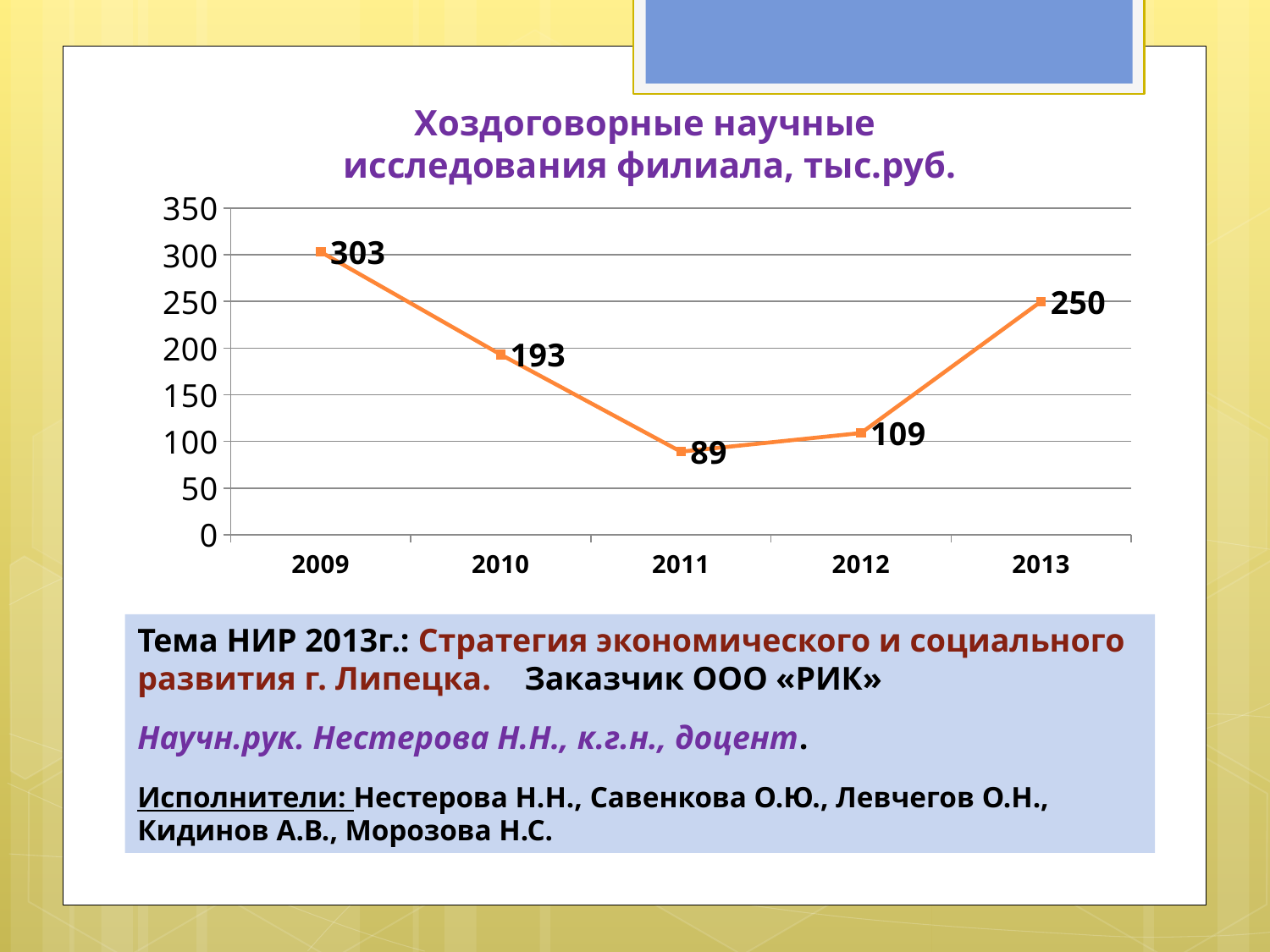
What is the difference between the values for 2010 and 2011? 104 Which year has the lowest value? 2011 What is the value for 2009? 303 What is the value for 2013? 250 Is the value for 2012 greater or less than 150? less How many years are plotted on the chart? 5 Which is larger, the value for 2010 or the value for 2012? 2010 What is the difference between the values for 2009 and 2013? 53 What kind of chart is shown on the slide? line chart Do the values rise or fall from 2009 to 2011? fall Which year has the highest value? 2009 What is the value for 2011? 89